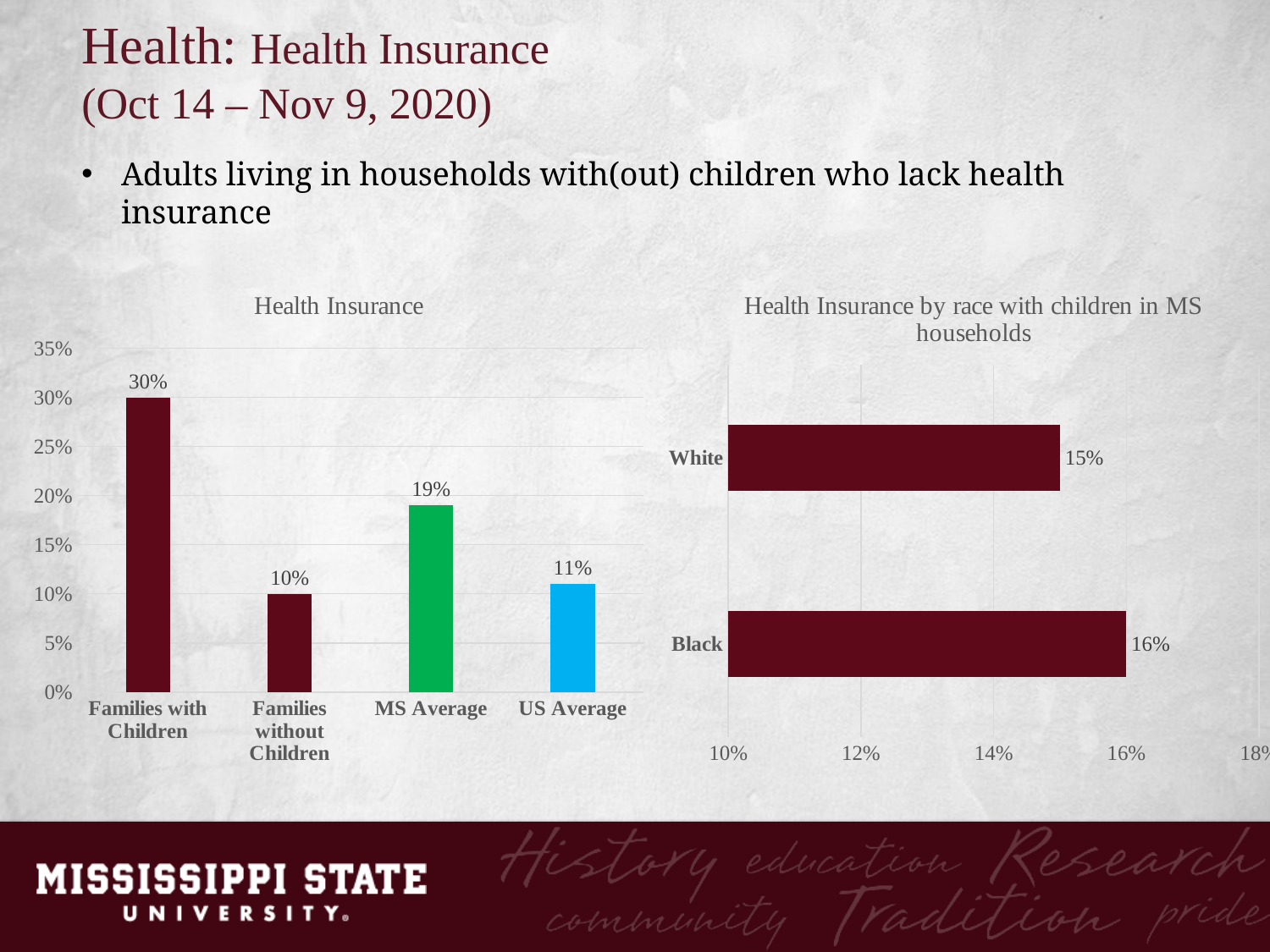
In the 'Health Insurance' chart, which category has the lowest value? Families without Children In the 'Health Insurance' chart, what is the value for Families with Children? 30% How many categories are shown in the 'Health Insurance' chart? 4 What kind of chart is the 'Health Insurance' chart? Bar chart In the 'Health Insurance' chart, what colour is the US Average bar? Light blue In the 'Health Insurance by race with children in MS households' chart, what is the difference between Black and White? 1% In the 'Health Insurance' chart, which category has the highest value? Families with Children In the 'Health Insurance by race with children in MS households' chart, what is the value for White? 15% In the 'Health Insurance by race with children in MS households' chart, what is the value for Black? 16% In the 'Health Insurance' chart, what is the difference between Families with Children and Families without Children? 20% In the 'Health Insurance' chart, which is larger, MS Average or US Average? MS Average In the 'Health Insurance' chart, what is the value for MS Average? 19%